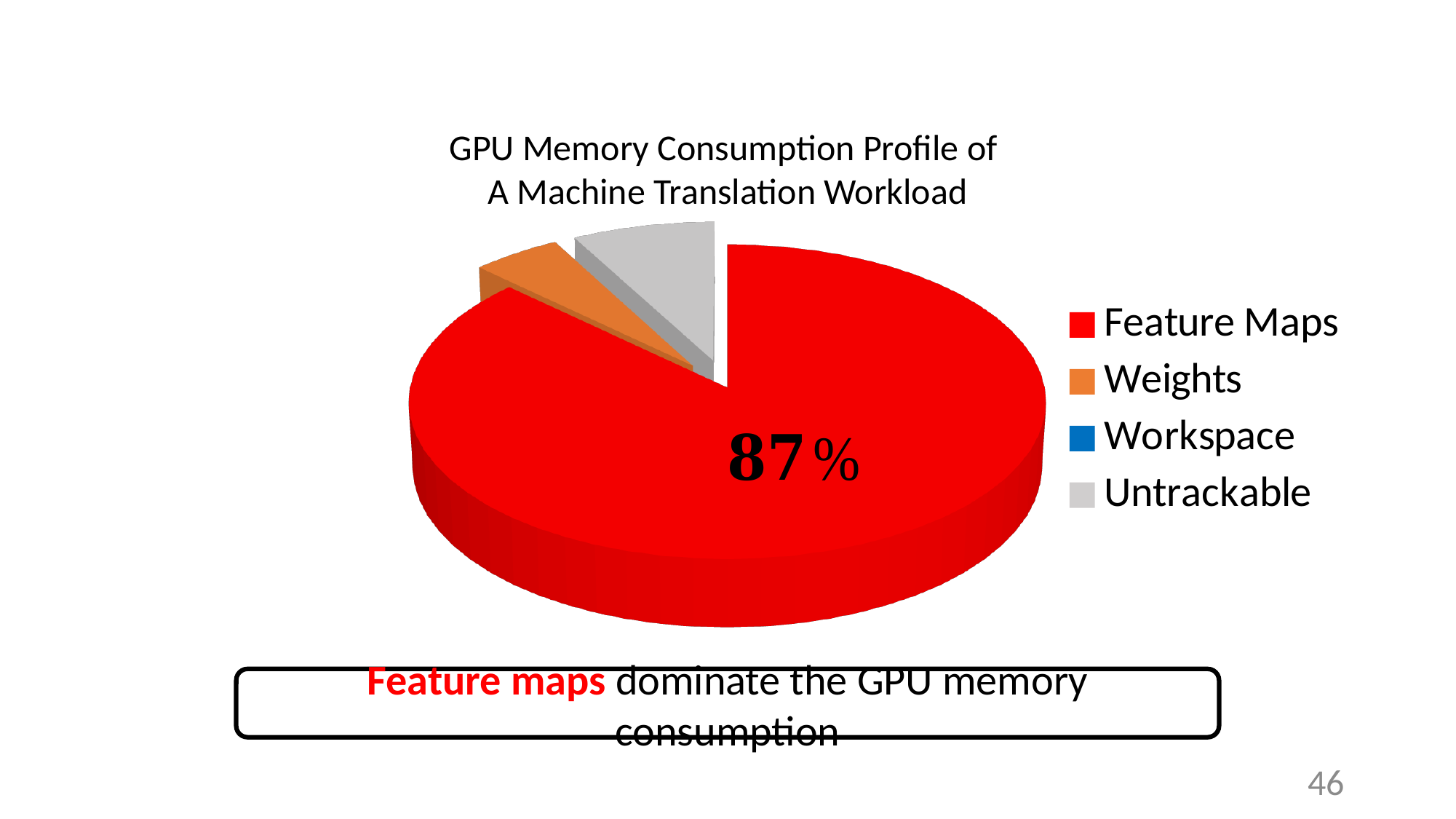
Which is larger, the slice for Untrackable or the slice for Feature Maps? Feature Maps What kind of chart is shown on the slide? pie chart What is the title of the chart? GPU Memory Consumption Profile of A Machine Translation Workload Which category has the largest slice of the pie? Feature Maps Which is larger, the slice for Feature Maps or the slice for Weights? Feature Maps How many categories does the legend list? 4 Which colour represents Weights in the chart? orange Which category is shown in gray in the legend? Untrackable What share of GPU memory consumption do Feature Maps account for? 87% What value is printed as a data label on the chart? 87%